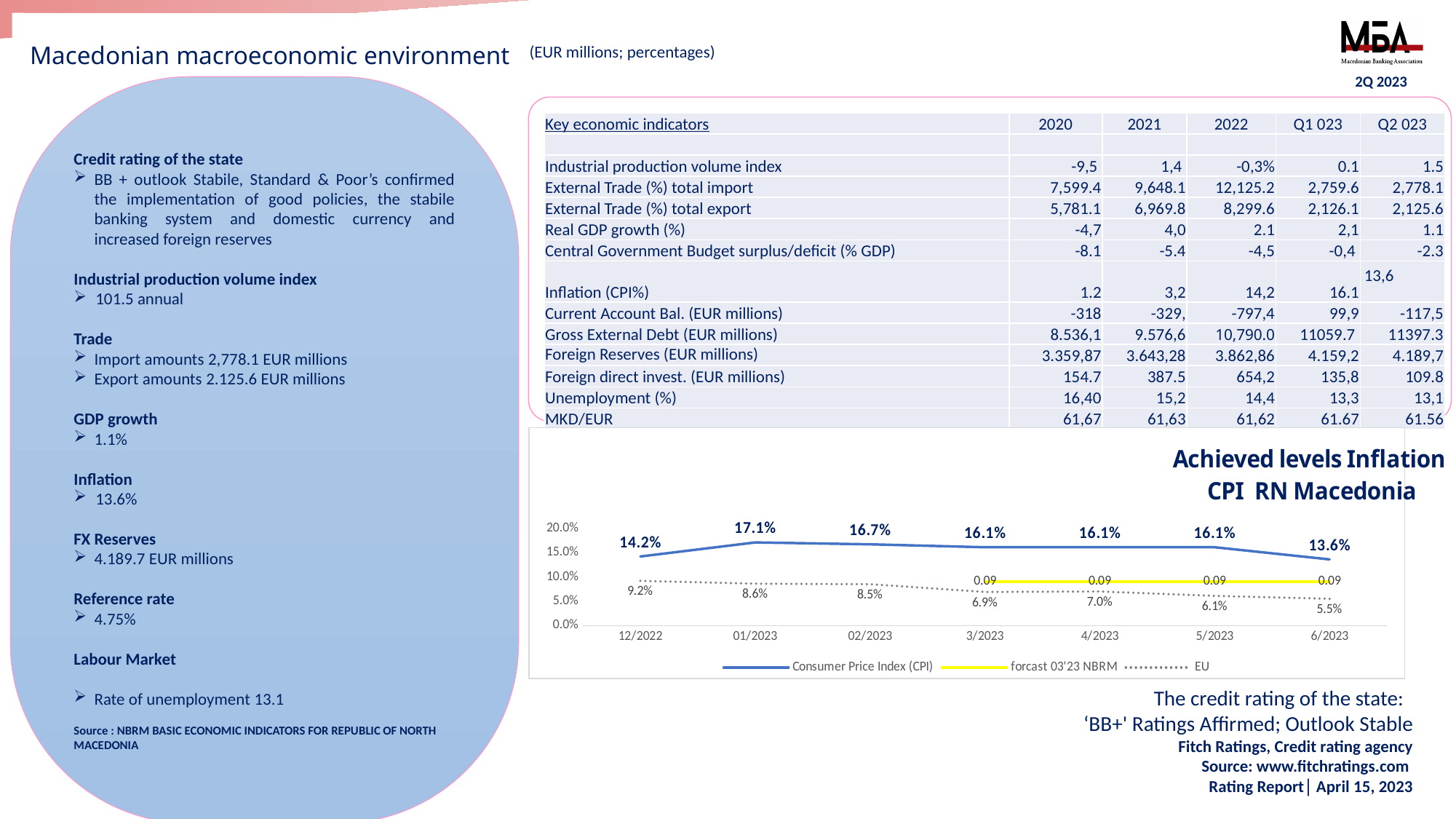
In the inflation chart, what is the difference between the CPI value and the EU value for 12/2022? 5.0% What type of chart is shown under the title 'Achieved levels Inflation CPI RN Macedonia'? line chart In the inflation chart, what is the CPI value for 6/2023? 13.6% In the inflation chart, what is the Consumer Price Index (CPI) value for 01/2023? 17.1% In the inflation chart, which is larger for 5/2023: the CPI value or the EU value? CPI In the inflation chart, which month has the highest Consumer Price Index (CPI) value? 01/2023 In the inflation chart, does the EU series rise or fall from 12/2022 to 6/2023? fall How many series does the legend of the inflation chart list? 3 In the inflation chart, what is the value of the 'forcast 03'23 NBRM' series at 4/2023? 0.09 In the inflation chart, what is the EU value for 6/2023? 5.5% In the inflation chart, which month has the lowest EU value? 6/2023 How many months are shown on the x axis of the inflation chart? 7